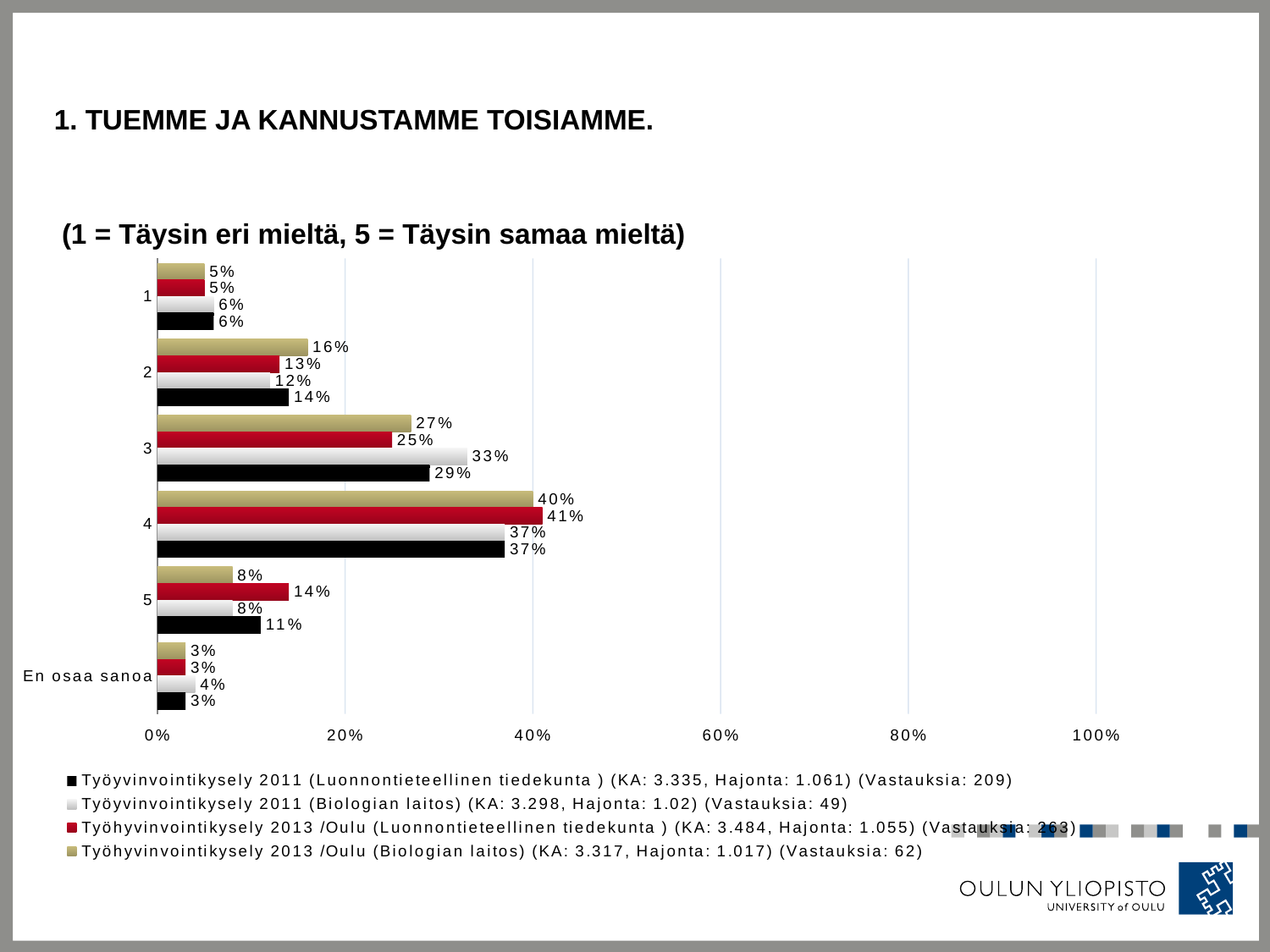
What is the value for category 5 in the Työyvinvointikysely 2011 (Luonnontieteellinen tiedekunta) series? 11% What is the title of the slide? 1. TUEMME JA KANNUSTAMME TOISIAMME. What is the value for category 3 in the Työyvinvointikysely 2011 (Biologian laitos) series? 33% What is the value for category 4 in the Työhyvinvointikysely 2013 /Oulu (Luonnontieteellinen tiedekunta) series? 41% Which category has the highest value in the Työhyvinvointikysely 2013 /Oulu (Biologian laitos) series? 4 What is the difference between the Työyvinvointikysely 2011 (Biologian laitos) value and the Työhyvinvointikysely 2013 /Oulu (Luonnontieteellinen tiedekunta) value for category 3? 8% What kind of chart is shown on the slide? bar chart Which category has the lowest value in the Työyvinvointikysely 2011 (Biologian laitos) series? En osaa sanoa How many categories are shown on the vertical axis of the chart? 6 For category 5, which is larger: the Työhyvinvointikysely 2013 /Oulu (Luonnontieteellinen tiedekunta) value or the Työhyvinvointikysely 2013 /Oulu (Biologian laitos) value? Työhyvinvointikysely 2013 /Oulu (Luonnontieteellinen tiedekunta) What is the value for category 2 in the Työhyvinvointikysely 2013 /Oulu (Biologian laitos) series? 16% How many series does the legend list? 4